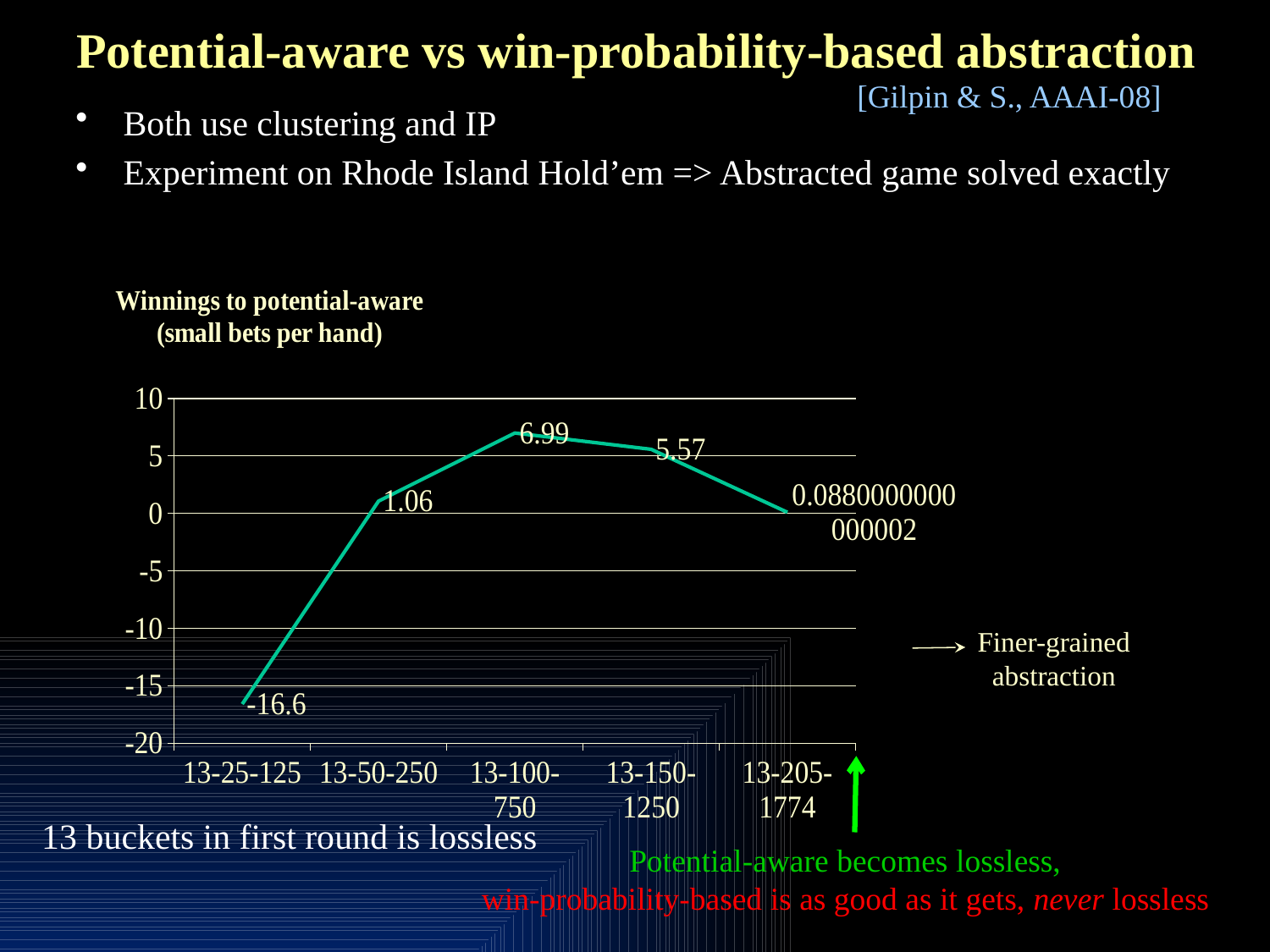
Is the value for 13-25-125 greater or less than -10? less What is the difference between the values for 13-100-750 and 13-150-1250? 1.42 What is the value for the 13-100-750 abstraction? 6.99 Which abstraction has the lowest winnings to potential-aware? 13-25-125 What is the value for the 13-25-125 abstraction? -16.6 What kind of chart is shown on the slide? line chart What is the y-axis label of the chart? Winnings to potential-aware (small bets per hand) What is the value for the 13-150-1250 abstraction? 5.57 How many abstraction categories are plotted on the x axis? 5 Which abstraction has the highest winnings to potential-aware? 13-100-750 What is the value for the 13-50-250 abstraction? 1.06 Which is larger, the value for 13-50-250 or the value for 13-150-1250? 13-150-1250